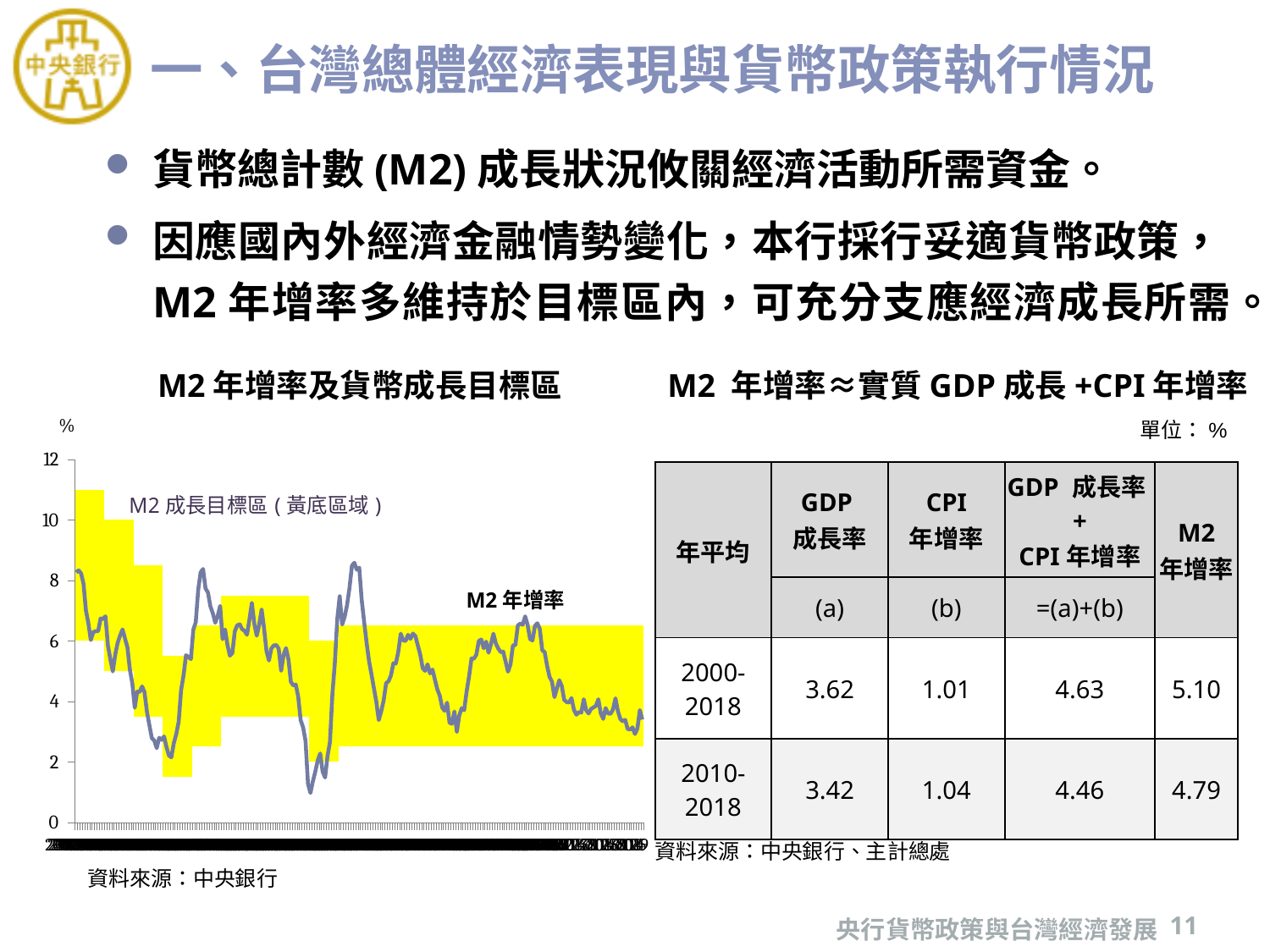
In the chart 'M2 年增率及貨幣成長目標區', is the M2 年增率 value at the far right of the chart greater or less than 6? less In the chart 'M2 年增率及貨幣成長目標區', is the highest point of the M2 年增率 line greater or less than 8? greater In the chart 'M2 年增率及貨幣成長目標區', does the M2 年增率 line overall rise or fall from the left end to the right end of the x axis? fall What kind of chart is shown under the title 'M2 年增率及貨幣成長目標區'? line chart In the chart 'M2 年增率及貨幣成長目標區', is the upper edge of the yellow target band at the far left greater or less than 10? greater In the chart 'M2 年增率及貨幣成長目標區', what is the highest value shown on the y axis? 12 In the chart 'M2 年增率及貨幣成長目標區', what does the yellow shaded area represent? M2 成長目標區 In the chart 'M2 年增率及貨幣成長目標區', what unit is shown on the y axis? % In the chart 'M2 年增率及貨幣成長目標區', is the M2 年增率 value at the far left of the chart larger or smaller than the value at the far right? larger